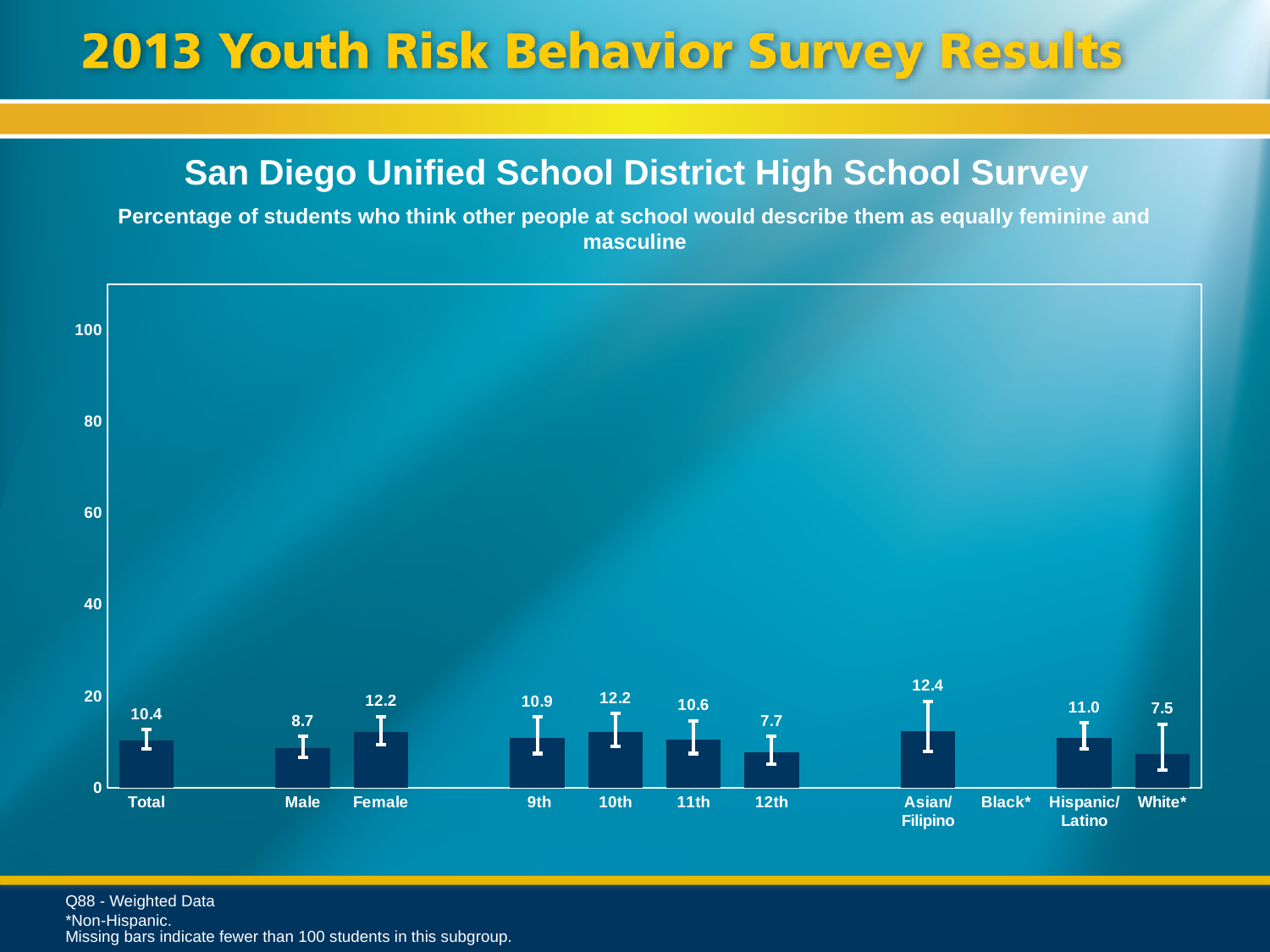
What kind of chart is shown? bar chart Is the value for Asian/Filipino greater or less than 20? less Which is larger, the value for 9th grade or 11th grade? 9th Which category has no bar shown? Black* How many categories are labeled on the x axis? 11 What is the difference between the Female and Male values? 3.5 What is the value for Female? 12.2 Which category with a bar has the lowest value? White* Which category has the highest value? Asian/Filipino What is the value for Hispanic/Latino? 11.0 What is the value for 12th grade? 7.7 What is the value for Total? 10.4